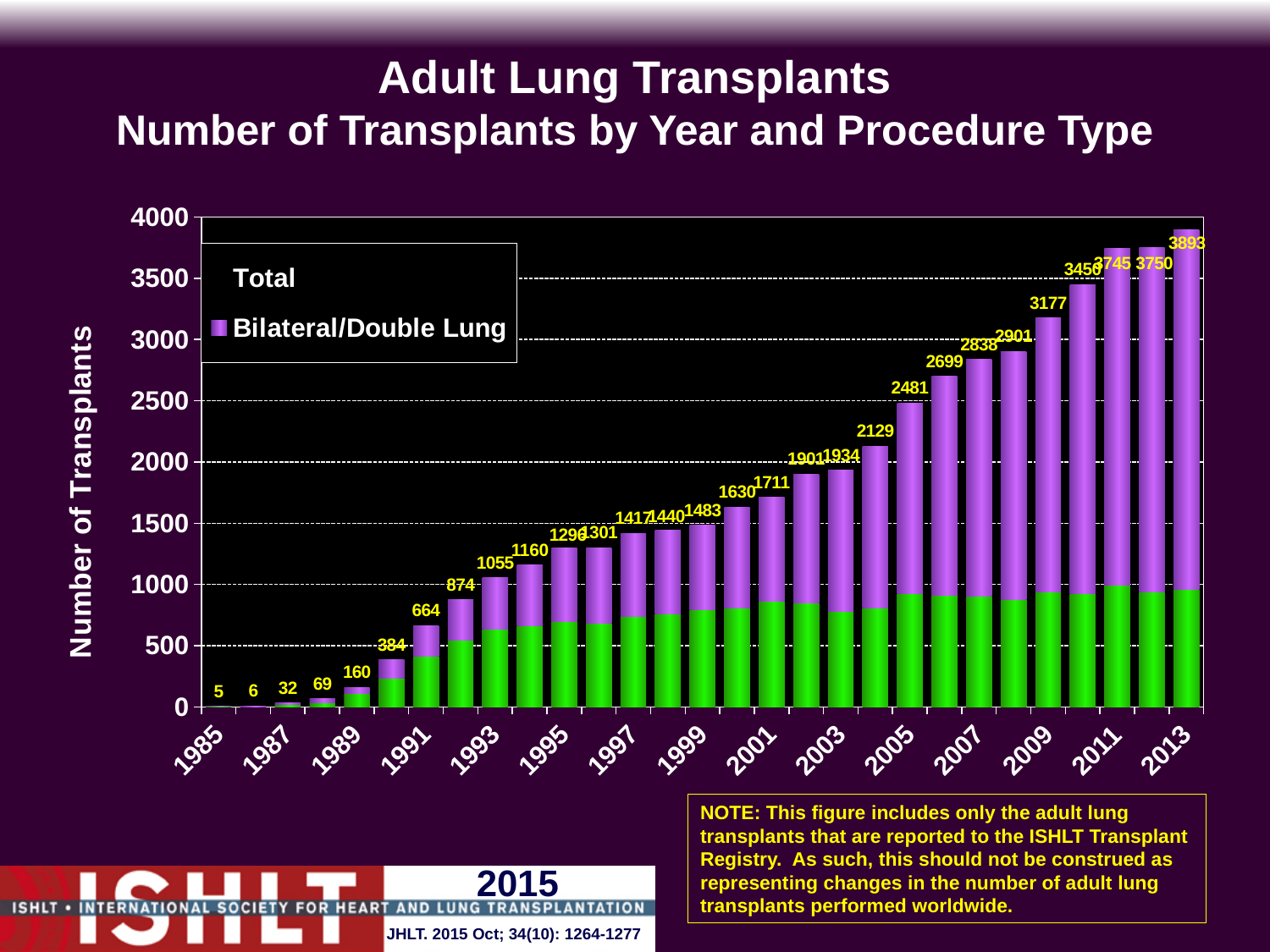
How many years (bars) are plotted on the chart? 29 Do the total transplant numbers generally rise or fall from 1985 to 2013? Rise What is the total number of transplants labelled for 1990? 384 What is the difference between the total transplants in 2013 and in 2012? 143 What is the total number of transplants labelled for 1995? 1296 Which year has a larger total, 2009 or 2010? 2010 Which year has the highest total number of transplants? 2013 What is the total number of adult lung transplants shown for 2013? 3893 What kind of chart is shown on the slide? Stacked bar chart Which year has the lowest total number of transplants? 1985 What is the total number of transplants labelled for 2005? 2481 Is the Bilateral/Double Lung value for 2013 greater or less than 2500? greater